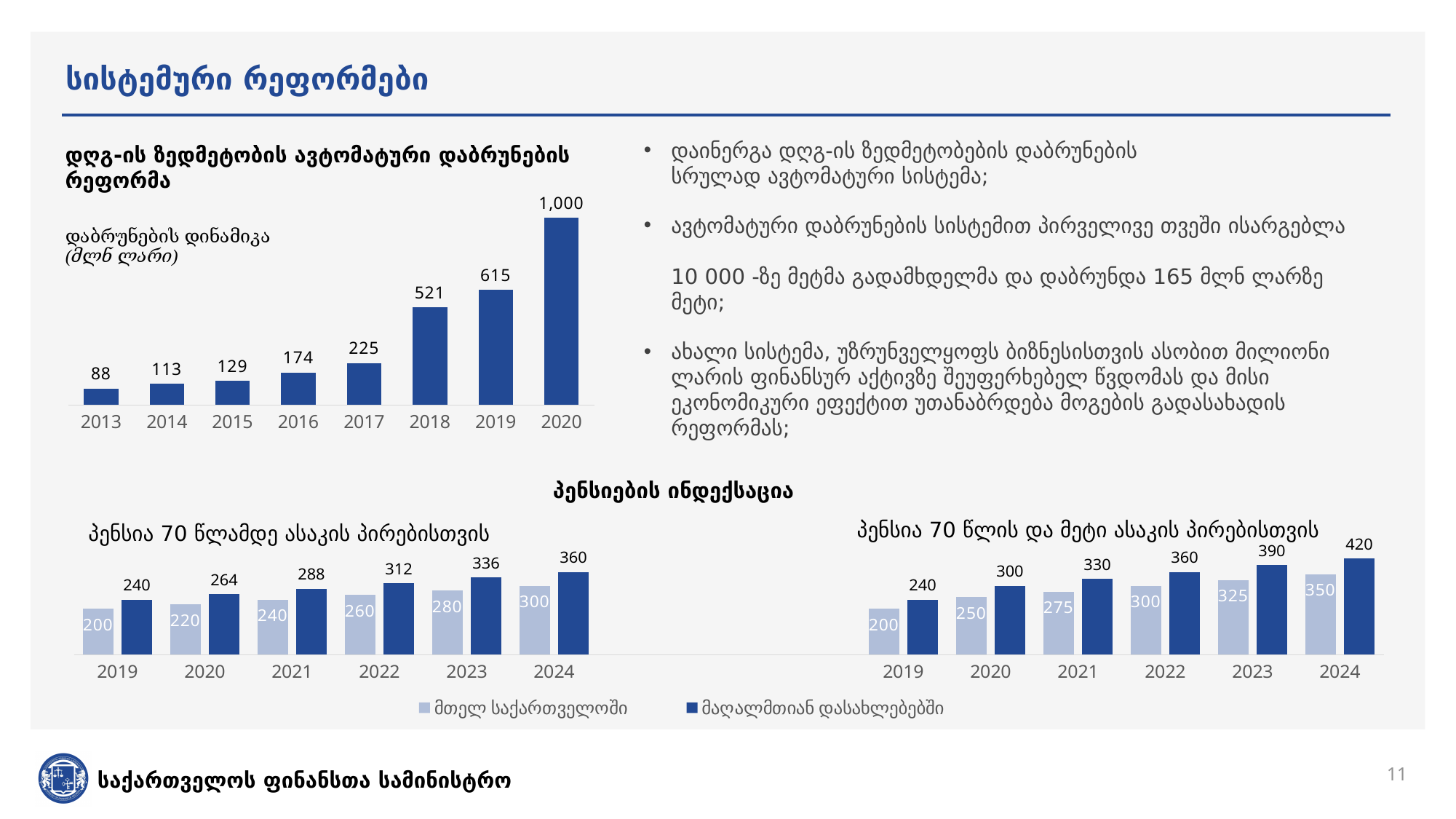
In the top-left chart (დაბრუნების დინამიკა), what is the difference between the values for 2019 and 2018? 94 What kind of chart is the top-left chart (დაბრუნების დინამიკა)? bar chart In the top-left chart (დაბრუნების დინამიკა), what is the value for 2020? 1,000 In the bottom-right chart (პენსია 70 წლის და მეტი ასაკის პირებისთვის), what is the difference between მაღალმთიან დასახლებებში and მთელ საქართველოში in 2021? 55 In the bottom-right chart (პენსია 70 წლის და მეტი ასაკის პირებისთვის), what is the value for მაღალმთიან დასახლებებში in 2024? 420 In the top-left chart (დაბრუნების დინამიკა), do the values rise or fall from 2013 to 2020? rise In the top-left chart (დაბრუნების დინამიკა), what is the value for 2017? 225 In the bottom-left chart (პენსია 70 წლამდე ასაკის პირებისთვის), what is the value for მთელ საქართველოში in 2024? 300 In the top-left chart (დაბრუნების დინამიკა), how many years are shown on the x axis? 8 In the top-left chart (დაბრუნების დინამიკა), which year has the lowest value? 2013 In the bottom-left chart (პენსია 70 წლამდე ასაკის პირებისთვის), what is the value for მაღალმთიან დასახლებებში in 2022? 312 How many series does the legend list for the bottom pension charts? 2